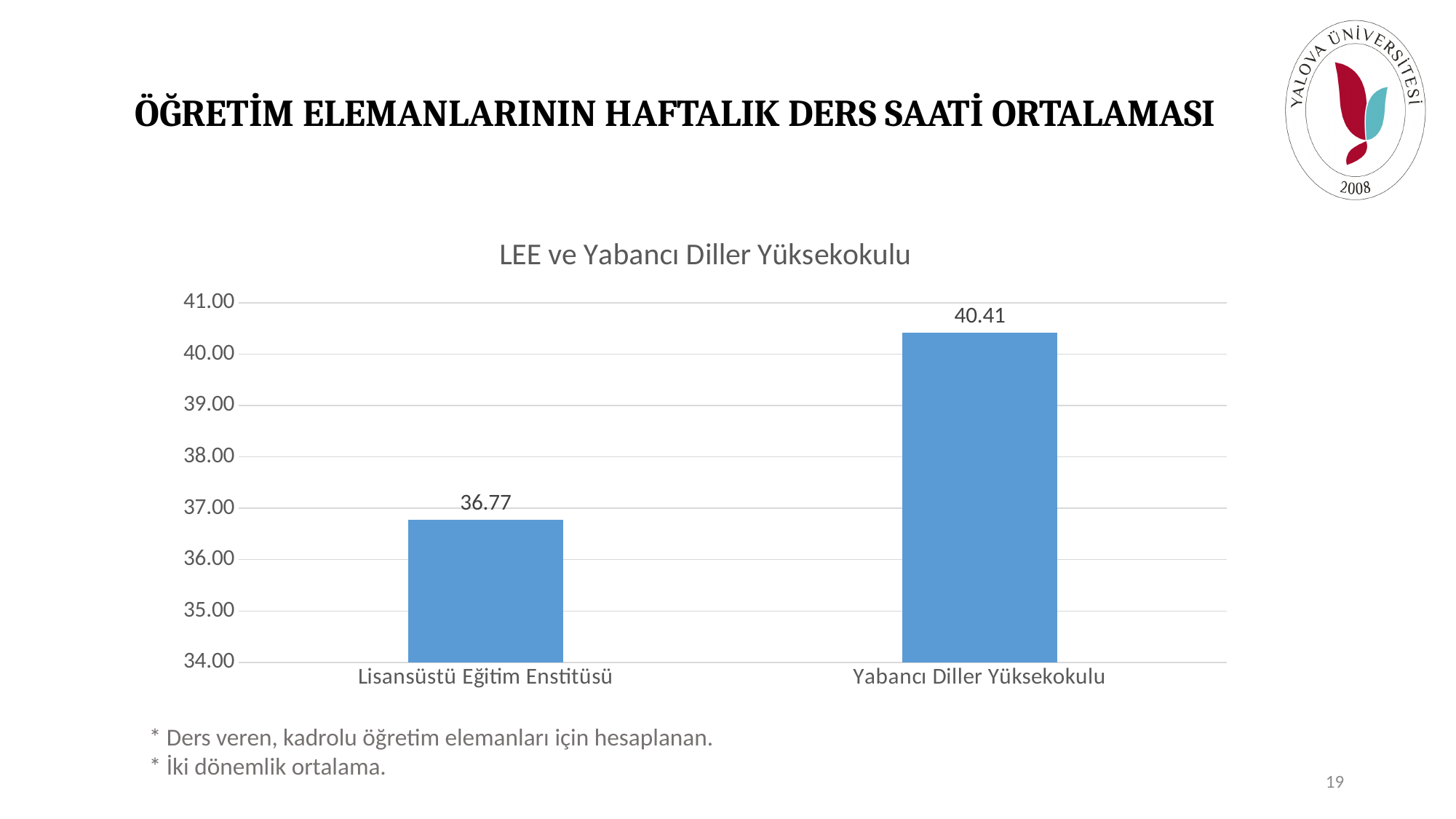
What is the lowest value shown on the vertical axis? 34.00 Is the value for Yabancı Diller Yüksekokulu greater or less than 40.00? greater Is the value for Lisansüstü Eğitim Enstitüsü greater or less than 37.00? less What is the title of the chart? LEE ve Yabancı Diller Yüksekokulu What is the difference between the values for Yabancı Diller Yüksekokulu and Lisansüstü Eğitim Enstitüsü? 3.64 Which category has the lowest value? Lisansüstü Eğitim Enstitüsü Which is larger, the value for Lisansüstü Eğitim Enstitüsü or the value for Yabancı Diller Yüksekokulu? Yabancı Diller Yüksekokulu What kind of chart is shown on the slide? bar chart What is the value for Lisansüstü Eğitim Enstitüsü? 36.77 What is the value for Yabancı Diller Yüksekokulu? 40.41 How many categories are shown in the chart? 2 Which category has the highest value? Yabancı Diller Yüksekokulu